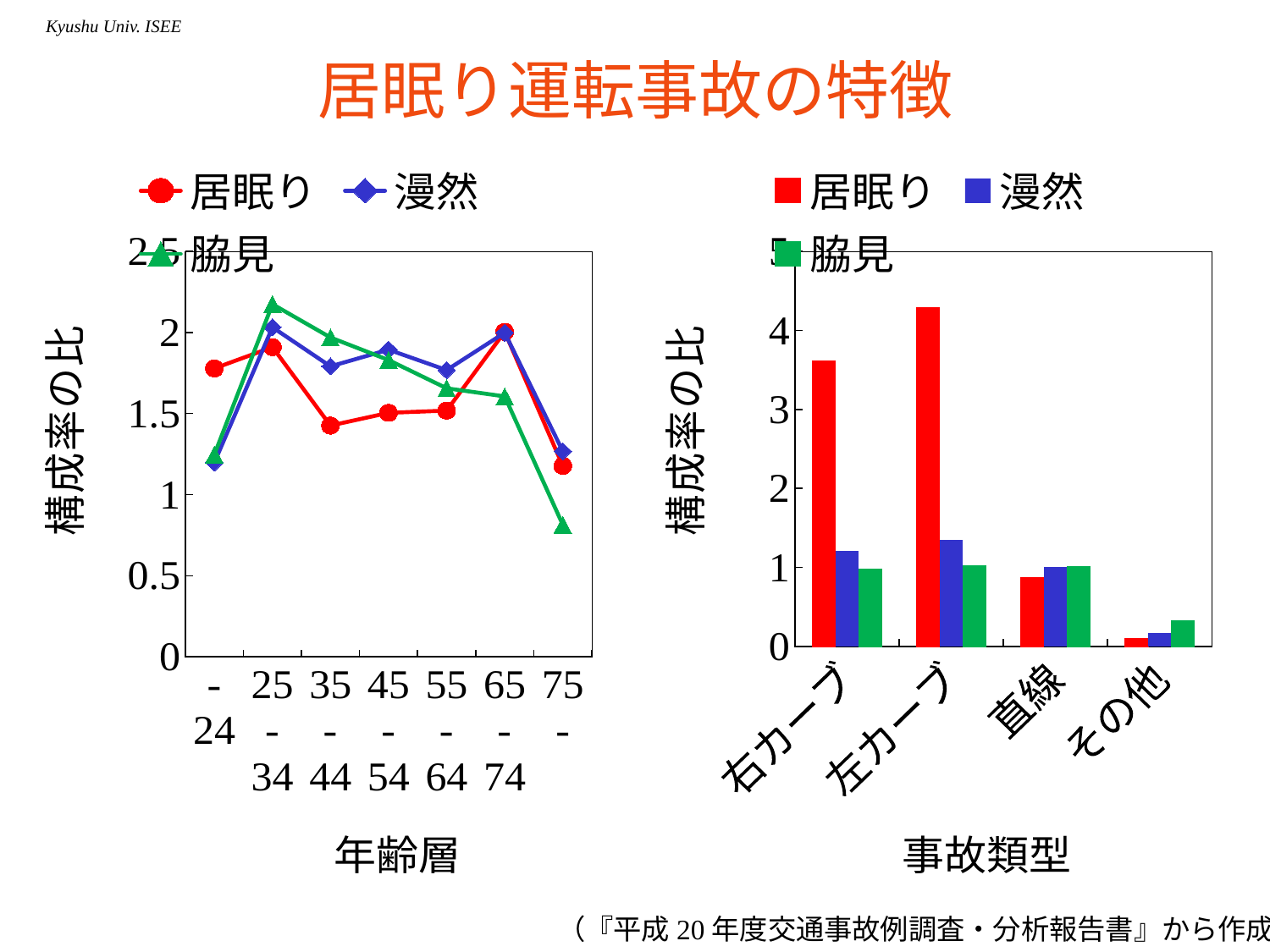
How many series does the legend of the right-hand chart (事故類型) list? 3 In the left-hand chart (年齢層), which series has the lowest value at the 75- age group? 脇見 In the right-hand chart (事故類型), which category has the lowest 居眠り value? その他 How many age groups are shown on the x axis of the left-hand chart (年齢層)? 7 In the right-hand chart (事故類型), is the 居眠り value for 右カーブ greater or less than 3? greater What kind of chart is the left-hand chart (年齢層)? line chart In the right-hand chart (事故類型), which category has the highest 居眠り value? 左カーブ In the right-hand chart (事故類型), which is larger for 右カーブ: 居眠り or 漫然? 居眠り In the left-hand chart (年齢層), is the 脇見 value for the 75- age group greater or less than 1? less What kind of chart is the right-hand chart (事故類型)? bar chart In the right-hand chart (事故類型), is the 居眠り value for 左カーブ greater or less than 4? greater How many categories are shown on the x axis of the right-hand chart (事故類型)? 4